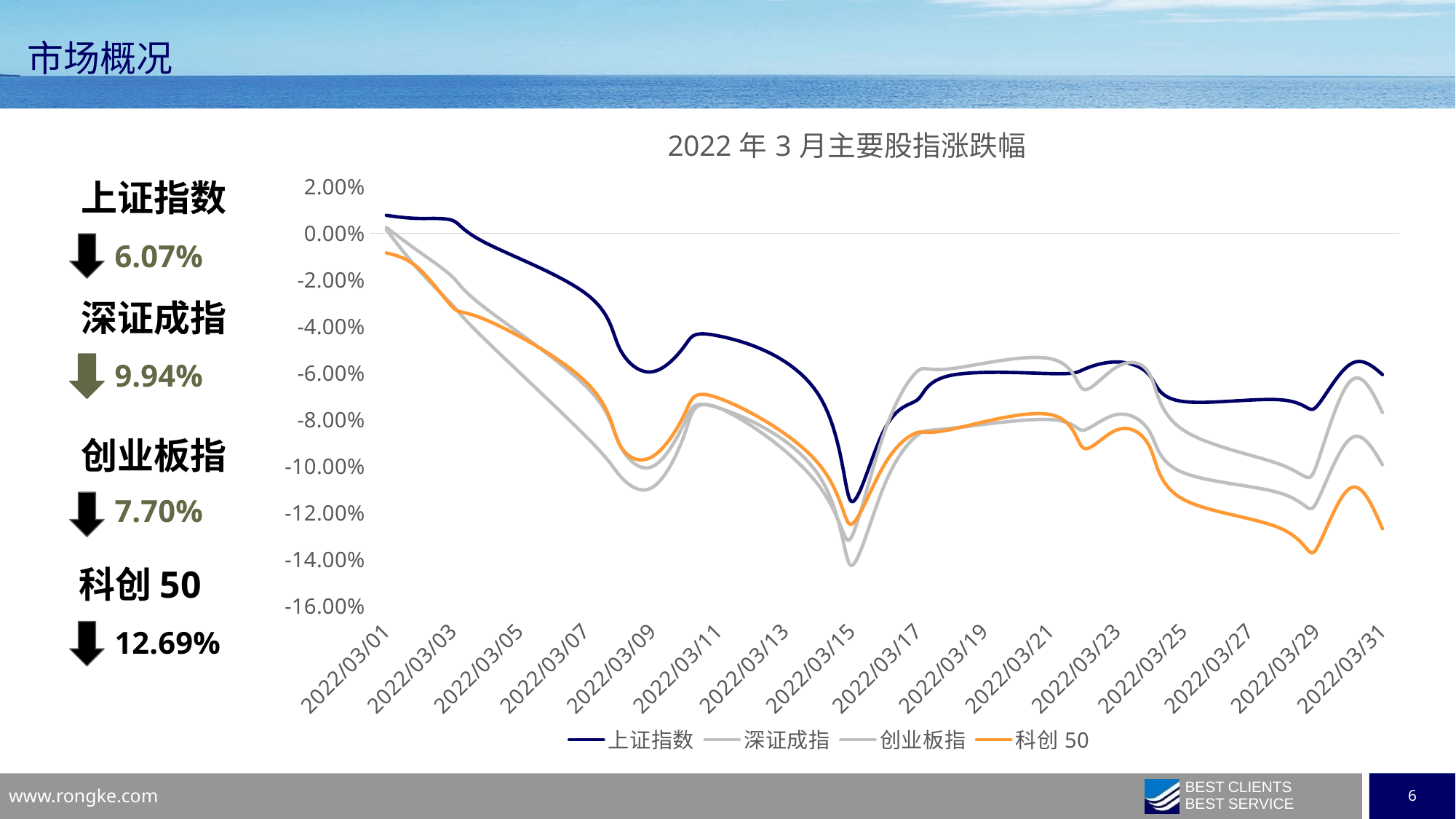
How many series does the chart legend list? 4 Is the value for 科创 50 at 2022/03/01 greater or less than 0.00%? less What is the title of the chart? 2022 年 3 月主要股指涨跌幅 How many date labels are shown on the x axis of the chart? 16 What type of chart is shown on the slide? line chart Is the value for 上证指数 at 2022/03/01 greater or less than 0.00%? greater Do the values for 科创 50 generally rise or fall from 2022/03/01 to 2022/03/31? fall Which series has the highest value at 2022/03/31 in the chart? 上证指数 Which series is drawn in orange in the chart? 科创 50 Is the value for 上证指数 at 2022/03/25 greater or less than -6.00%? less Which series has the lowest value at 2022/03/31 in the chart? 科创 50